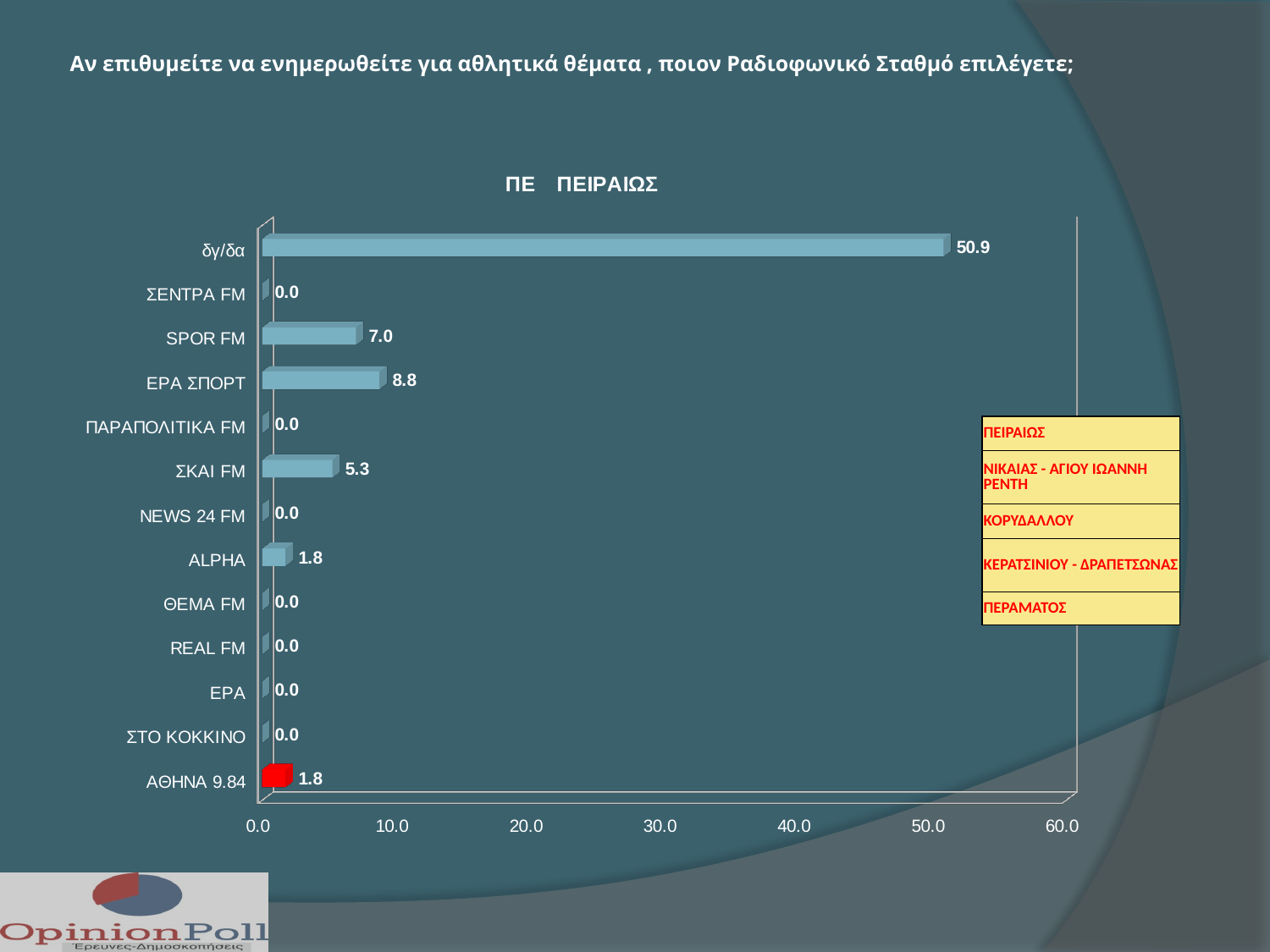
What kind of chart is shown on the slide? Bar chart What is the value for ΑΘΗΝΑ 9.84? 1.8 Which category has the highest value? δγ/δα What is the difference between the values for δγ/δα and ΕΡΑ ΣΠΟΡΤ? 42.1 What is the value for ΕΡΑ ΣΠΟΡΤ? 8.8 How many categories have a value of 0.0? 7 What is the difference between the values for ΕΡΑ ΣΠΟΡΤ and SPOR FM? 1.8 Is the value for δγ/δα greater or less than 50.0? greater Which is larger, the value for SPOR FM or the value for ΣΚΑΙ FM? SPOR FM What is the value for δγ/δα? 50.9 How many categories are shown on the chart? 13 What is the value for ΣΚΑΙ FM? 5.3